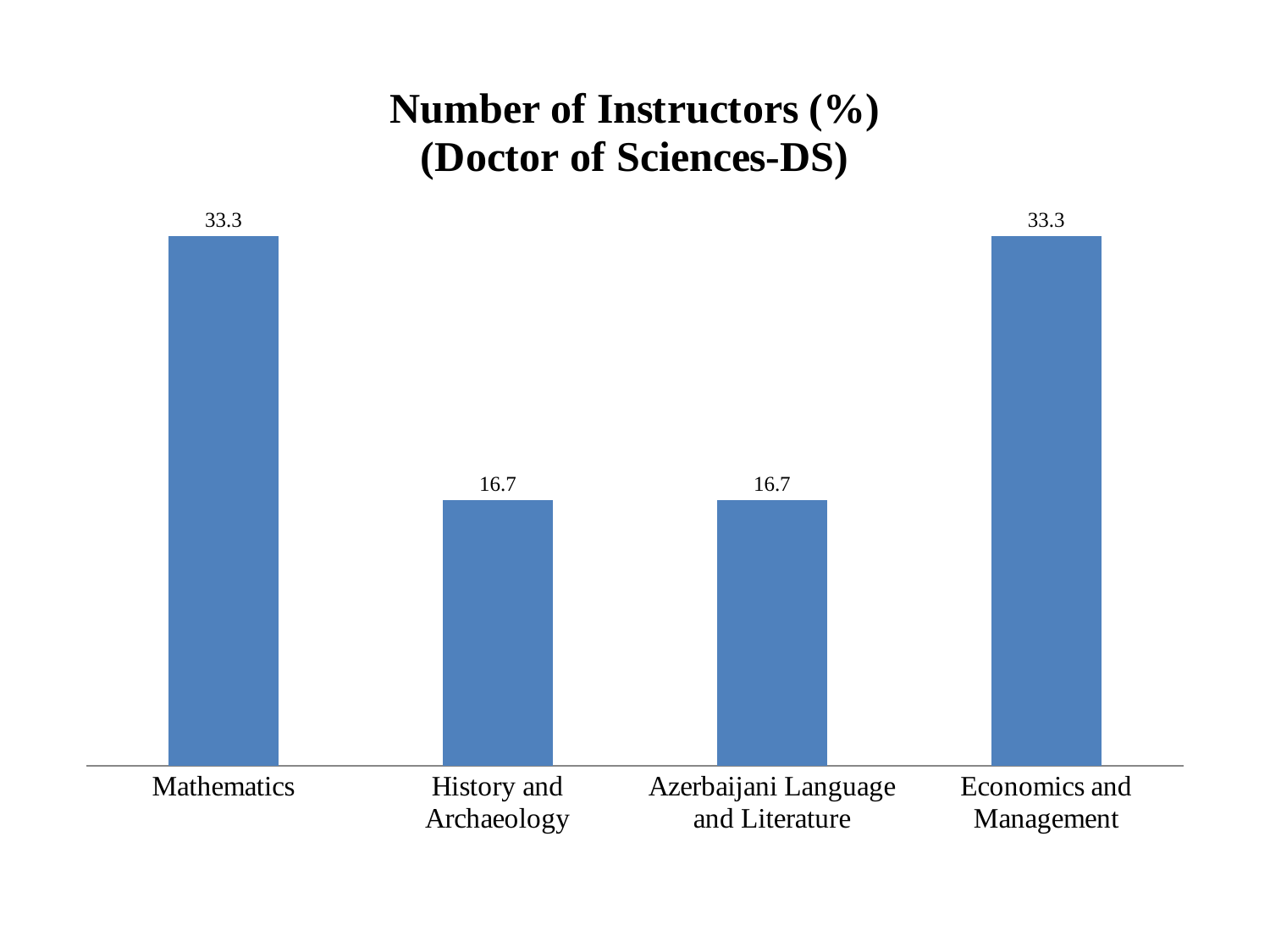
Which is larger, the value for History and Archaeology or the value for Mathematics? Mathematics What is the value for History and Archaeology? 16.7 What is the value for Economics and Management? 33.3 What is the value for Azerbaijani Language and Literature? 16.7 How many categories are shown on the chart? 4 What is the total of all four values shown on the chart? 100 What is the title of the chart? Number of Instructors (%) (Doctor of Sciences-DS) What is the value for Mathematics? 33.3 Which is larger, the value for Economics and Management or the value for Azerbaijani Language and Literature? Economics and Management What is the difference between the values for Mathematics and History and Archaeology? 16.6 What kind of chart is shown on the slide? Bar chart What colour are the bars on the chart? Blue